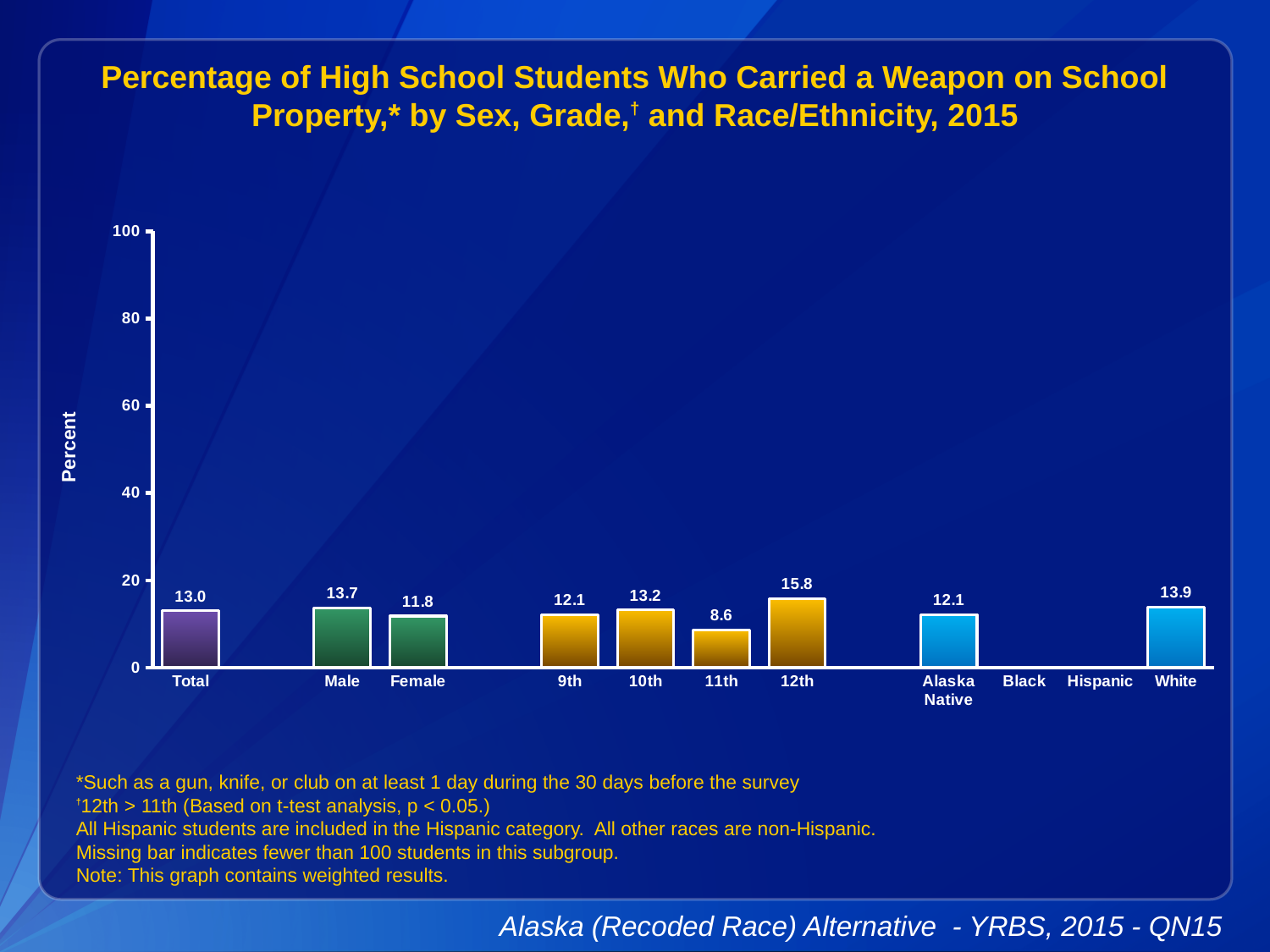
What is the value for Male? 13.7 Is the value for 12th greater or less than 20? less What is the value for Total? 13.0 Which category has the highest value? 12th What is the value for 11th grade? 8.6 Which categories have no bar shown? Black and Hispanic What kind of chart is this? bar chart How many categories have a bar plotted? 9 What is the difference between the values for Male and Female? 1.9 Which is larger, the value for 12th or the value for 9th? 12th Which category has the lowest value among the bars shown? 11th What is the value for White? 13.9